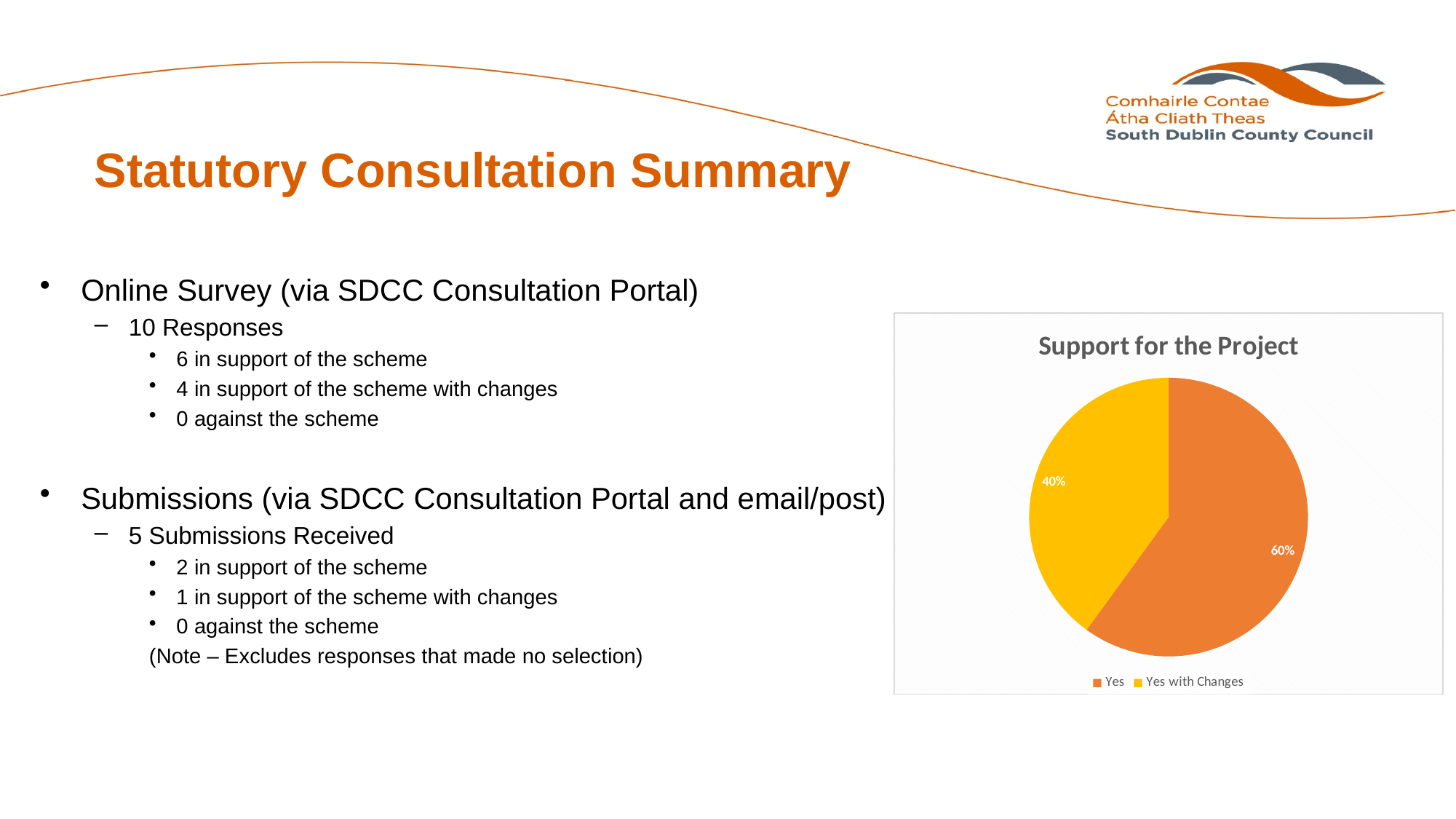
Which is larger, the "Yes" slice or the "Yes with Changes" slice? Yes What is the difference in percentage points between the "Yes" and "Yes with Changes" slices? 20% What colour is the "Yes with Changes" slice? yellow How many entries does the chart legend list? 2 Which slice is the smallest in the pie chart? Yes with Changes Which slice is the largest in the pie chart? Yes How many slices does the pie chart have? 2 What share of the pie does the "Yes" slice represent? 60% What share of the pie does the "Yes with Changes" slice represent? 40% What is the title of the chart? Support for the Project What kind of chart is shown on the slide? pie chart